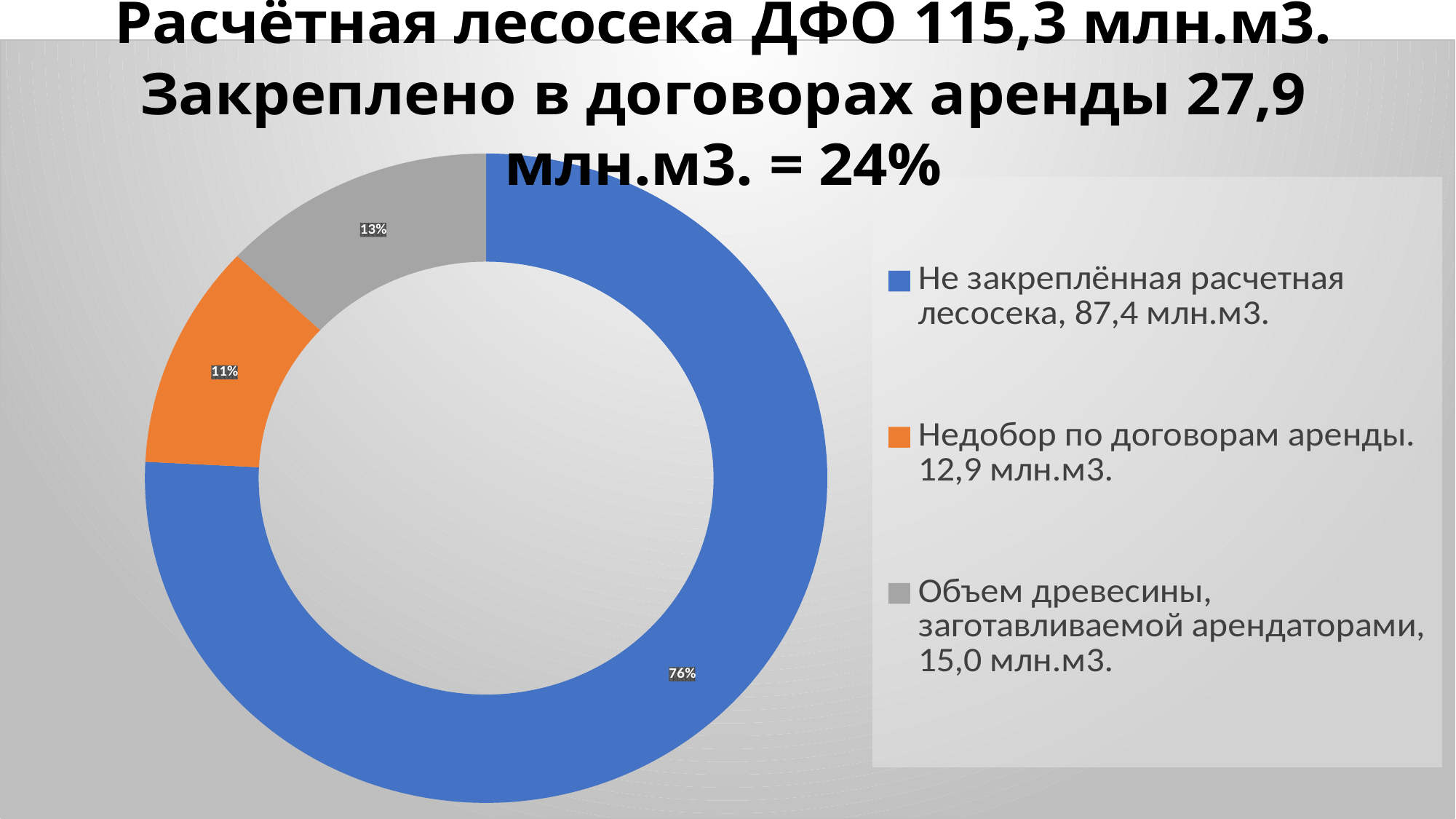
What colour is the slice for "Недобор по договорам аренды. 12,9 млн.м3."? Orange How many entries does the legend list? 3 Which category has the largest share of the doughnut chart? Не закреплённая расчетная лесосека, 87,4 млн.м3. What percentage is shown for "Объем древесины, заготавливаемой арендаторами, 15,0 млн.м3."? 13% Which is larger: the share for "Объем древесины, заготавливаемой арендаторами, 15,0 млн.м3." or the share for "Недобор по договорам аренды. 12,9 млн.м3."? Объем древесины, заготавливаемой арендаторами, 15,0 млн.м3. Which category has the smallest share of the doughnut chart? Недобор по договорам аренды. 12,9 млн.м3. What is the difference in percentage points between the 76% slice and the 13% slice? 63 What percentage is shown for "Не закреплённая расчетная лесосека, 87,4 млн.м3."? 76% What percentage is shown for "Недобор по договорам аренды. 12,9 млн.м3."? 11% What colour is the slice labelled 13%? Grey How many slices does the doughnut chart have? 3 What kind of chart is shown on the slide? Doughnut chart